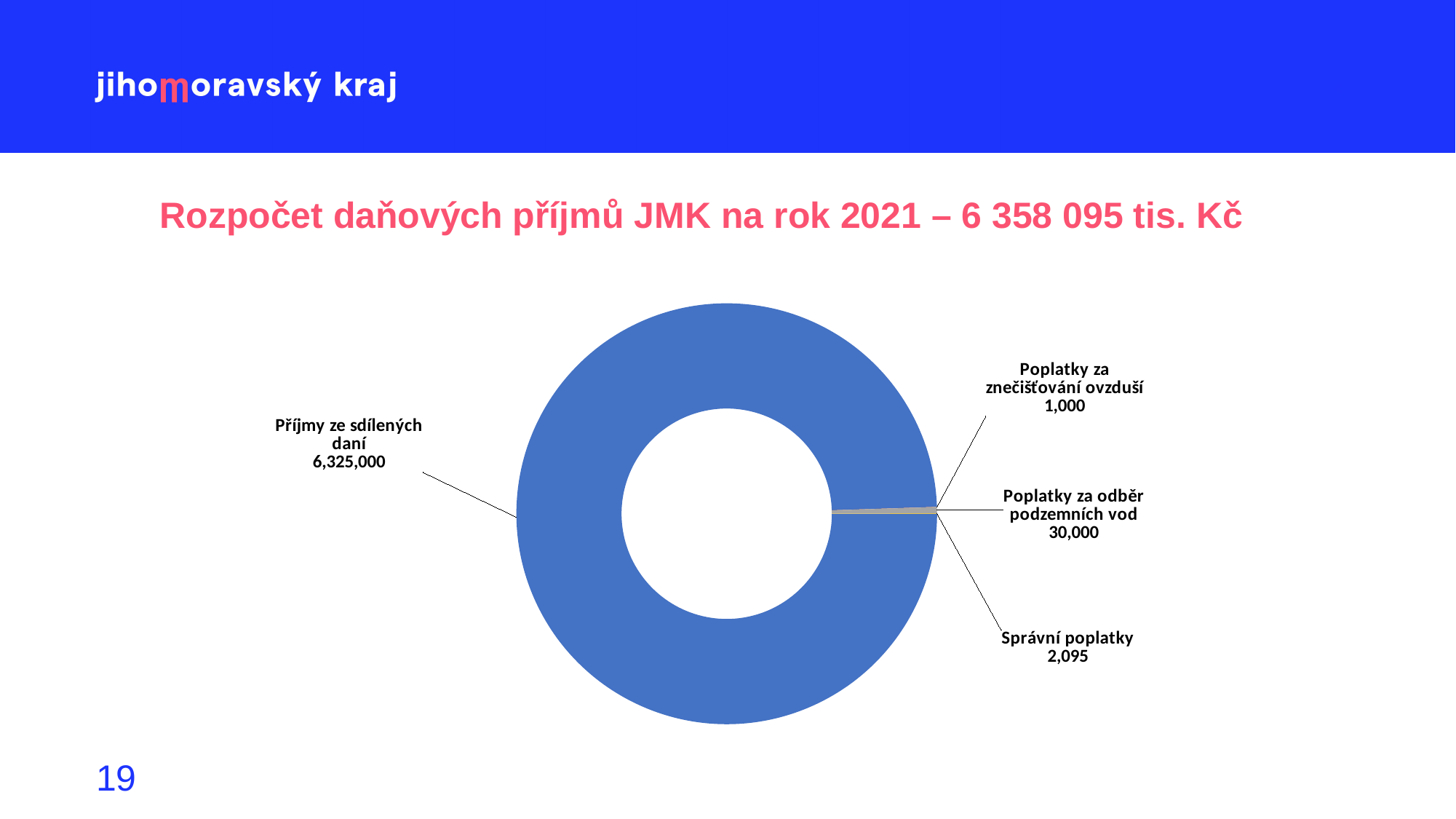
Which category has the smallest value? Poplatky za znečišťování ovzduší What is the difference between Správní poplatky and Poplatky za znečišťování ovzduší? 1,095 How many categories are shown in the chart? 4 What is the difference between Poplatky za odběr podzemních vod and Správní poplatky? 27,905 What is the value for Poplatky za znečišťování ovzduší? 1,000 What is the value for Poplatky za odběr podzemních vod? 30,000 What kind of chart is shown on the slide? doughnut chart Which is larger, Správní poplatky or Poplatky za znečišťování ovzduší? Správní poplatky What is the title of the slide above the chart? Rozpočet daňových příjmů JMK na rok 2021 – 6 358 095 tis. Kč What is the value for Správní poplatky? 2,095 What is the value for Příjmy ze sdílených daní? 6,325,000 Which category has the largest value? Příjmy ze sdílených daní